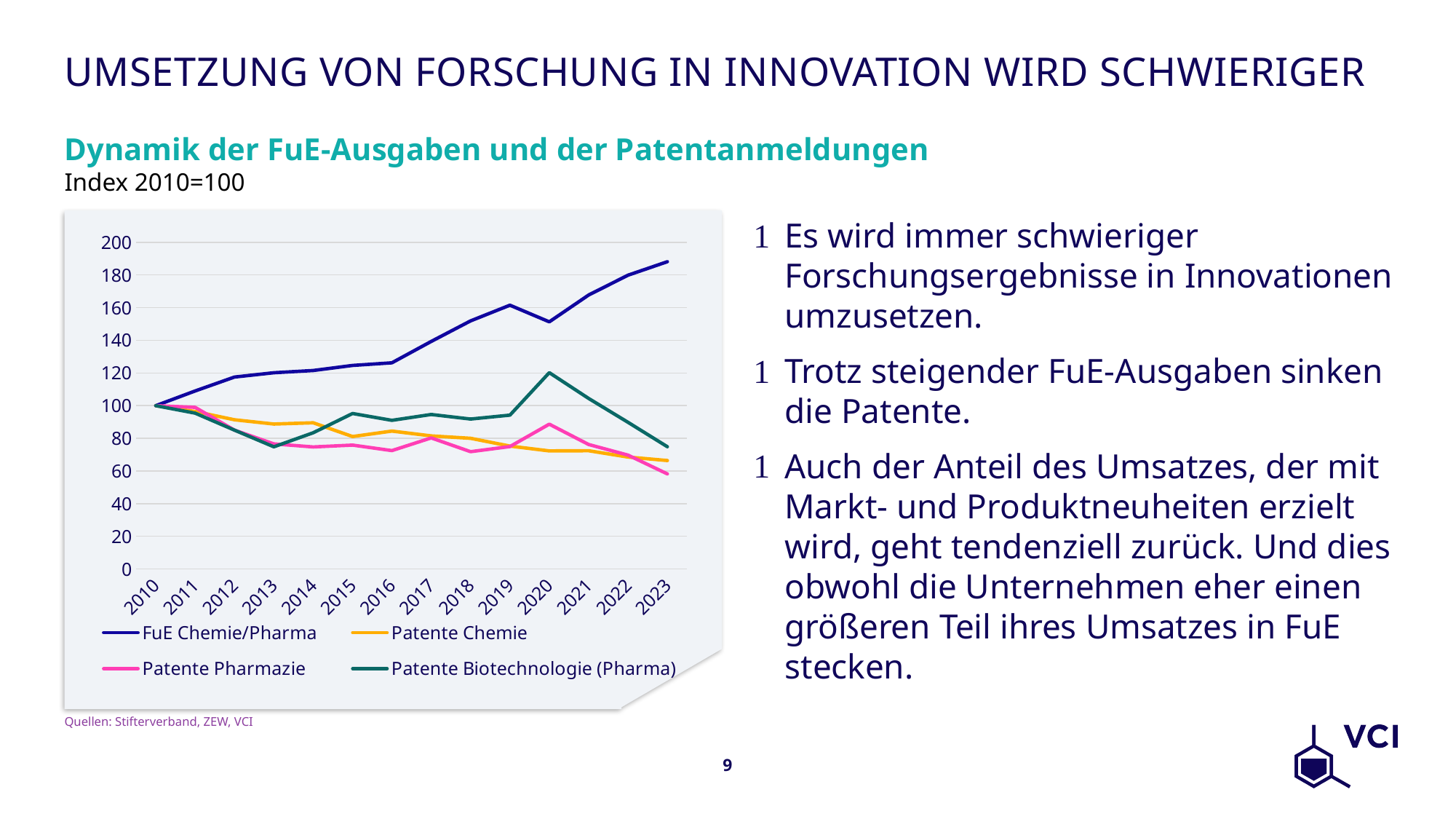
How many years are shown on the x axis of the chart? 14 Which series has the highest value in 2023? FuE Chemie/Pharma How many series does the chart legend list? 4 Does the FuE Chemie/Pharma line rise or fall overall from 2010 to 2023? rise What is the title of the chart? Dynamik der FuE-Ausgaben und der Patentanmeldungen Is the value for FuE Chemie/Pharma in 2023 greater or less than 180? greater Is the value for Patente Chemie in 2023 greater or less than 80? less What kind of chart is shown on the slide? line chart In 2020, which is larger: Patente Biotechnologie (Pharma) or Patente Pharmazie? Patente Biotechnologie (Pharma) What is the index value of FuE Chemie/Pharma in 2010? 100 Which series has the lowest value in 2023? Patente Pharmazie Is the value for FuE Chemie/Pharma in 2016 greater or less than 120? greater